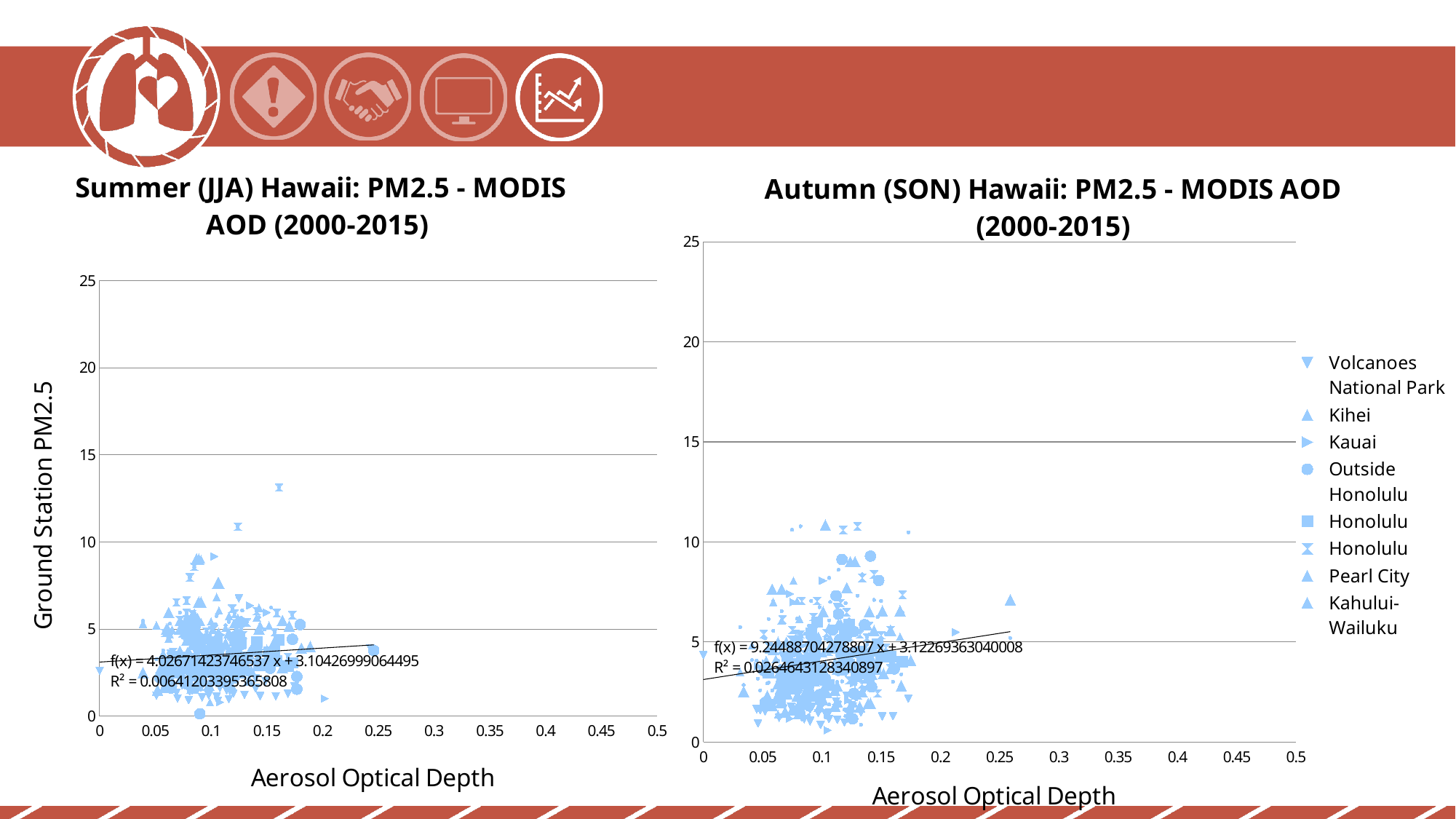
How many entries does the legend of the Autumn (SON) Hawaii chart list? 8 In the Summer (JJA) Hawaii chart, what is the trendline equation printed on the chart? f(x) = 4.02671423746537 x + 3.10426999064495 What is the y-axis label of the Summer (JJA) Hawaii chart? Ground Station PM2.5 In the Autumn (SON) Hawaii chart, what is the R² value printed for the trendline? 0.0264643128340897 What kind of chart is the Summer (JJA) Hawaii chart on the left? Scatter chart Which chart has the larger trendline slope, the Summer (JJA) chart or the Autumn (SON) chart? Autumn (SON) What kind of chart is the Autumn (SON) Hawaii chart on the right? Scatter chart In the Autumn (SON) Hawaii chart, is the highest plotted PM2.5 value greater or less than 15? less In the Autumn (SON) Hawaii chart, what is the trendline equation printed on the chart? f(x) = 9.24488704278807 x + 3.12269363040008 In the Summer (JJA) Hawaii chart, what is the R² value printed for the trendline? 0.00641203395365808 What is the x-axis label of the Summer (JJA) Hawaii chart? Aerosol Optical Depth In the Summer (JJA) Hawaii chart, is the highest plotted PM2.5 value greater or less than 10? greater